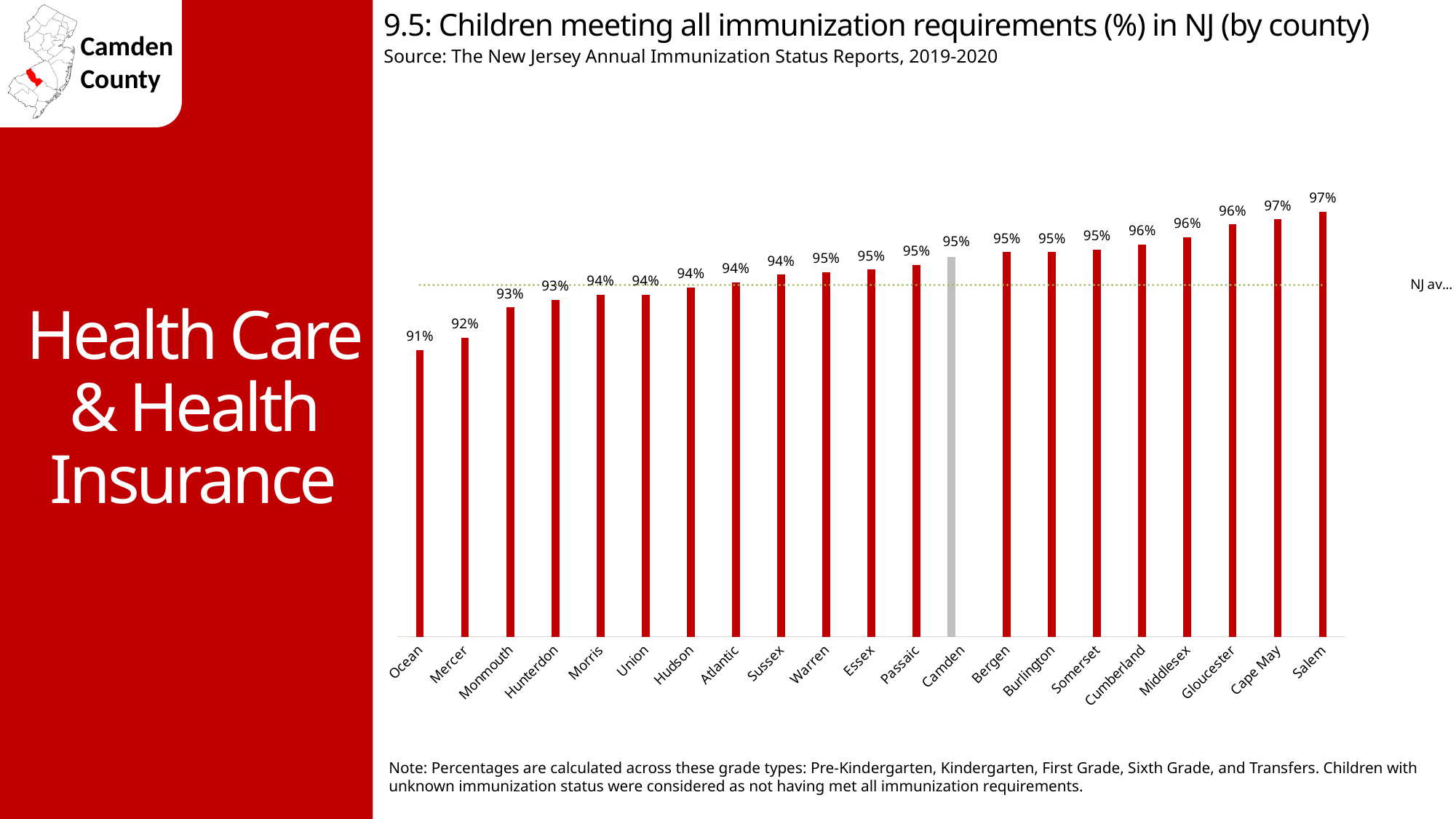
What is the value for Hunterdon County? 93% What is the difference in percentage points between Camden and Mercer? 3 percentage points Which county's bar is coloured grey instead of red? Camden What percentage is shown for Cumberland County? 96% What is the difference in percentage points between Salem and Ocean? 6 percentage points What is the value shown for Ocean County? 91% Do the values generally rise or fall moving from left to right along the x axis? Rise What kind of chart is used on this slide? Bar chart Which county has the lowest percentage of children meeting all immunization requirements? Ocean Which has a higher value, Camden or Monmouth? Camden What percentage of children in Camden County met all immunization requirements? 95% How many counties are shown on the chart? 21